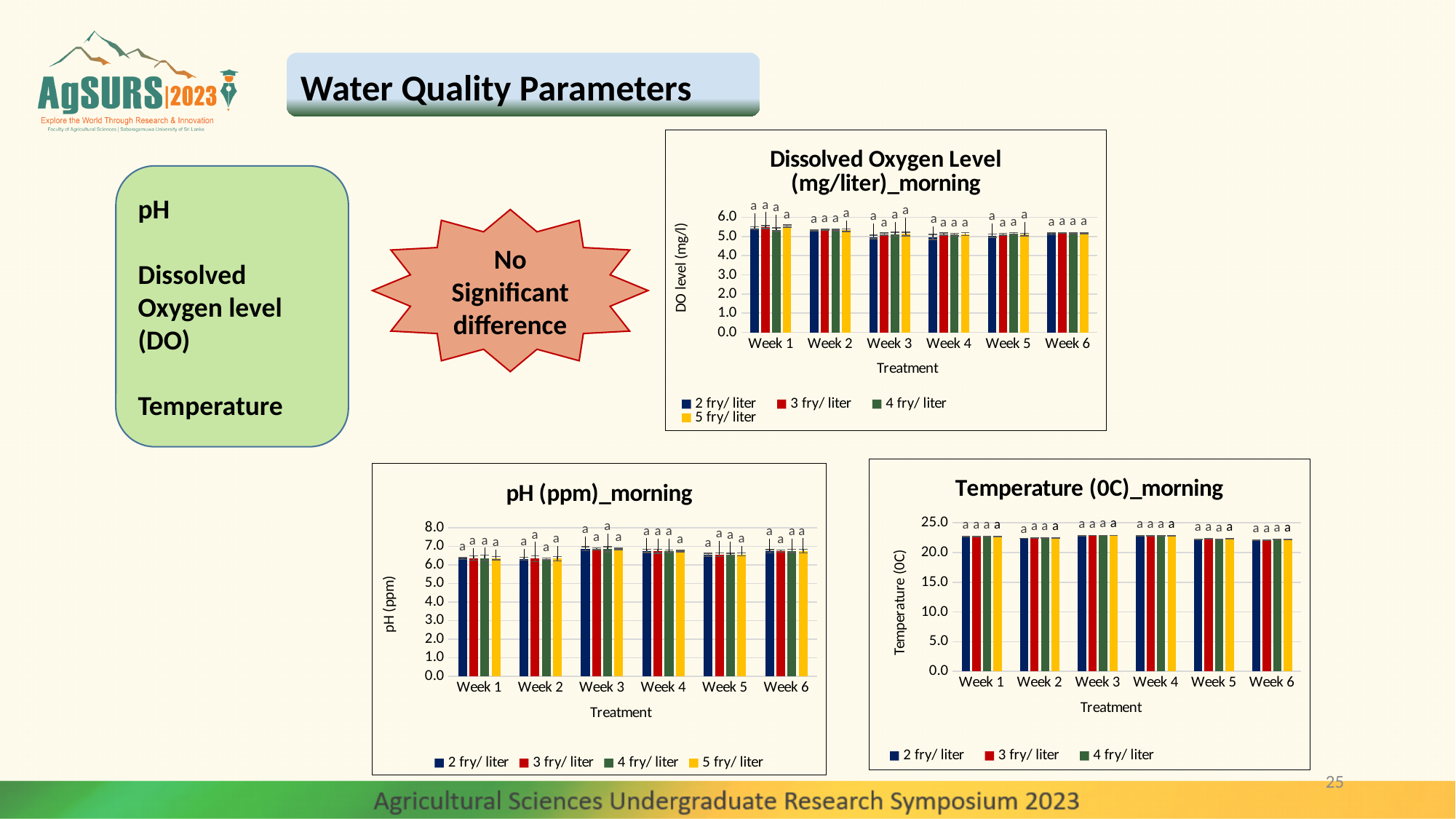
In the "pH (ppm)_morning" chart, is the value for 2 fry/liter in Week 3 greater or less than 6.0? greater In the "pH (ppm)_morning" chart, is the value for 5 fry/liter in Week 1 greater or less than 7.0? less How many series does the legend of the "Dissolved Oxygen Level (mg/liter)_morning" chart list? 4 How many week categories are shown on the x axis of the "pH (ppm)_morning" chart? 6 Which colour represents the 5 fry/liter series in the "pH (ppm)_morning" chart? yellow How many series does the legend of the "Temperature (0C)_morning" chart list? 3 In the "Temperature (0C)_morning" chart, is the value for 2 fry/liter in Week 1 greater or less than 20.0? greater What kind of chart is the "Dissolved Oxygen Level (mg/liter)_morning" chart? bar chart What is the x-axis title of the "Temperature (0C)_morning" chart? Treatment How many series does the legend of the "pH (ppm)_morning" chart list? 4